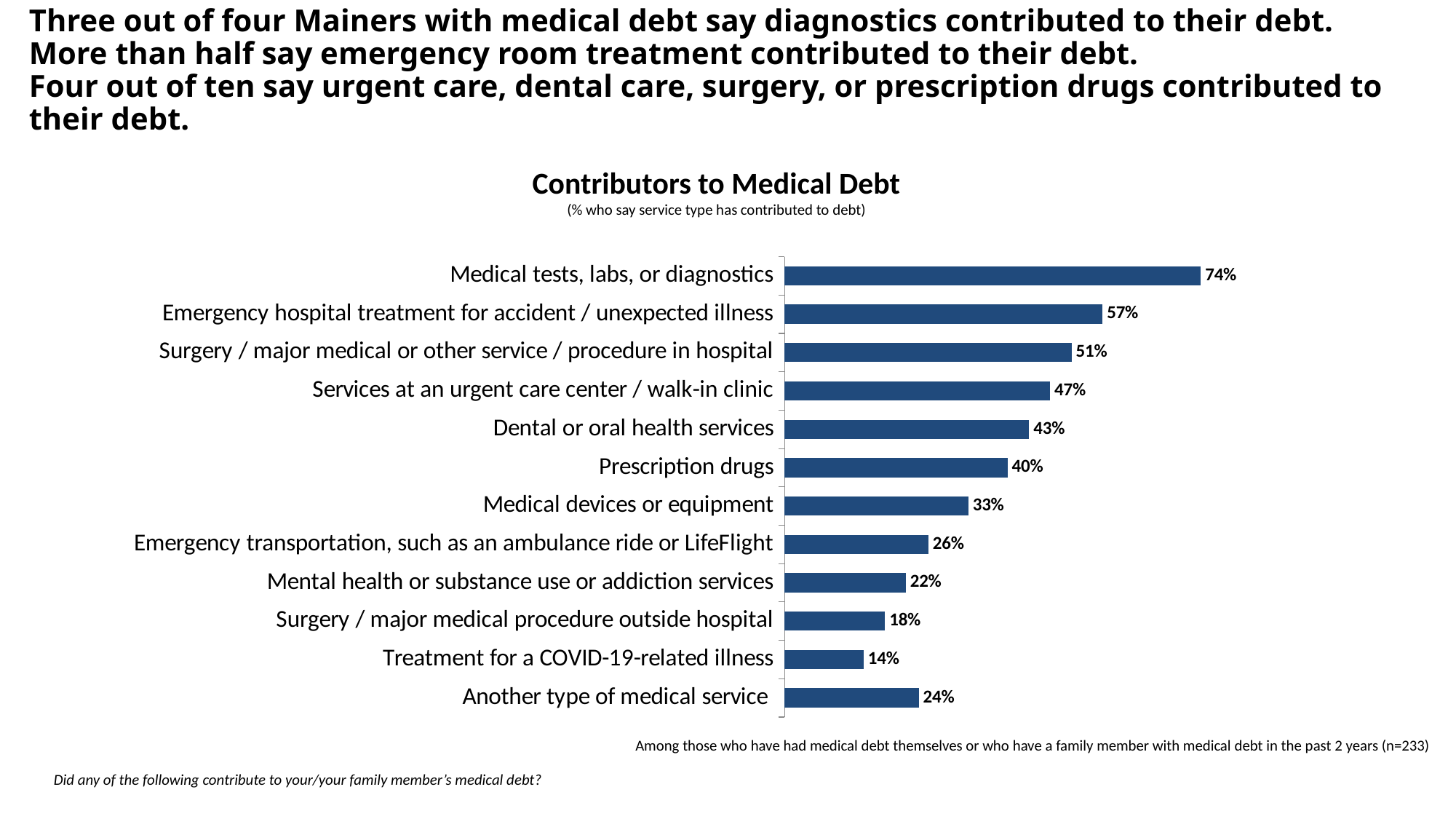
What is the value for Dental or oral health services? 43% Which is larger: the value for Medical devices or equipment or the value for Another type of medical service? Medical devices or equipment Which service type has the highest percentage in the chart? Medical tests, labs, or diagnostics What percentage say treatment for a COVID-19-related illness contributed to their debt? 14% How many service types (bars) are shown in the chart? 12 What is the title of the chart? Contributors to Medical Debt What is the sample size (n) stated below the chart? 233 Which service type has the lowest percentage in the chart? Treatment for a COVID-19-related illness What is the difference between the values for Services at an urgent care center / walk-in clinic and Mental health or substance use or addiction services? 25% What is the difference between the values for Emergency hospital treatment for accident / unexpected illness and Prescription drugs? 17% What kind of chart is shown on the slide? Bar chart What percentage say medical tests, labs, or diagnostics contributed to their medical debt? 74%